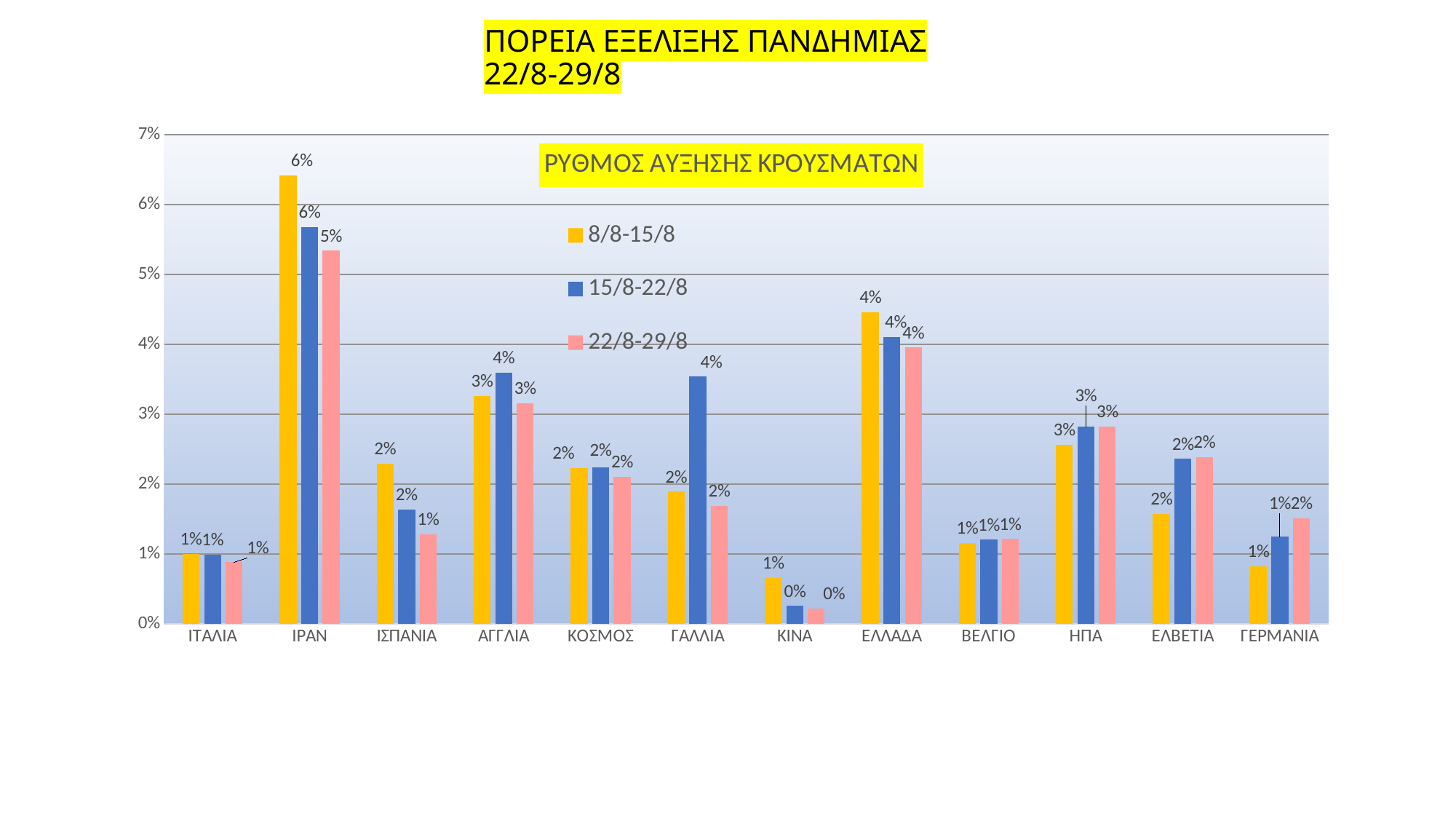
What is the value for ΙΡΑΝ in the 22/8-29/8 series? 5% Is the value for ΙΡΑΝ in the 8/8-15/8 series greater or less than 5%? greater Which category has the lowest value in the 22/8-29/8 series? ΚΙΝΑ How many countries/categories are shown on the x axis? 12 What is the title of the chart? ΡΥΘΜΟΣ ΑΥΞΗΣΗΣ ΚΡΟΥΣΜΑΤΩΝ In the 8/8-15/8 series, which is larger: ΙΡΑΝ or ΕΛΛΑΔΑ? ΙΡΑΝ Do the values for ΙΣΠΑΝΙΑ rise or fall from the 8/8-15/8 series to the 22/8-29/8 series? fall What is the value for ΚΙΝΑ in the 8/8-15/8 series? 1% How many series does the legend list? 3 What kind of chart is shown on the slide? bar chart What is the value for ΓΑΛΛΙΑ in the 15/8-22/8 series? 4% Which category has the highest value in the 8/8-15/8 series? ΙΡΑΝ